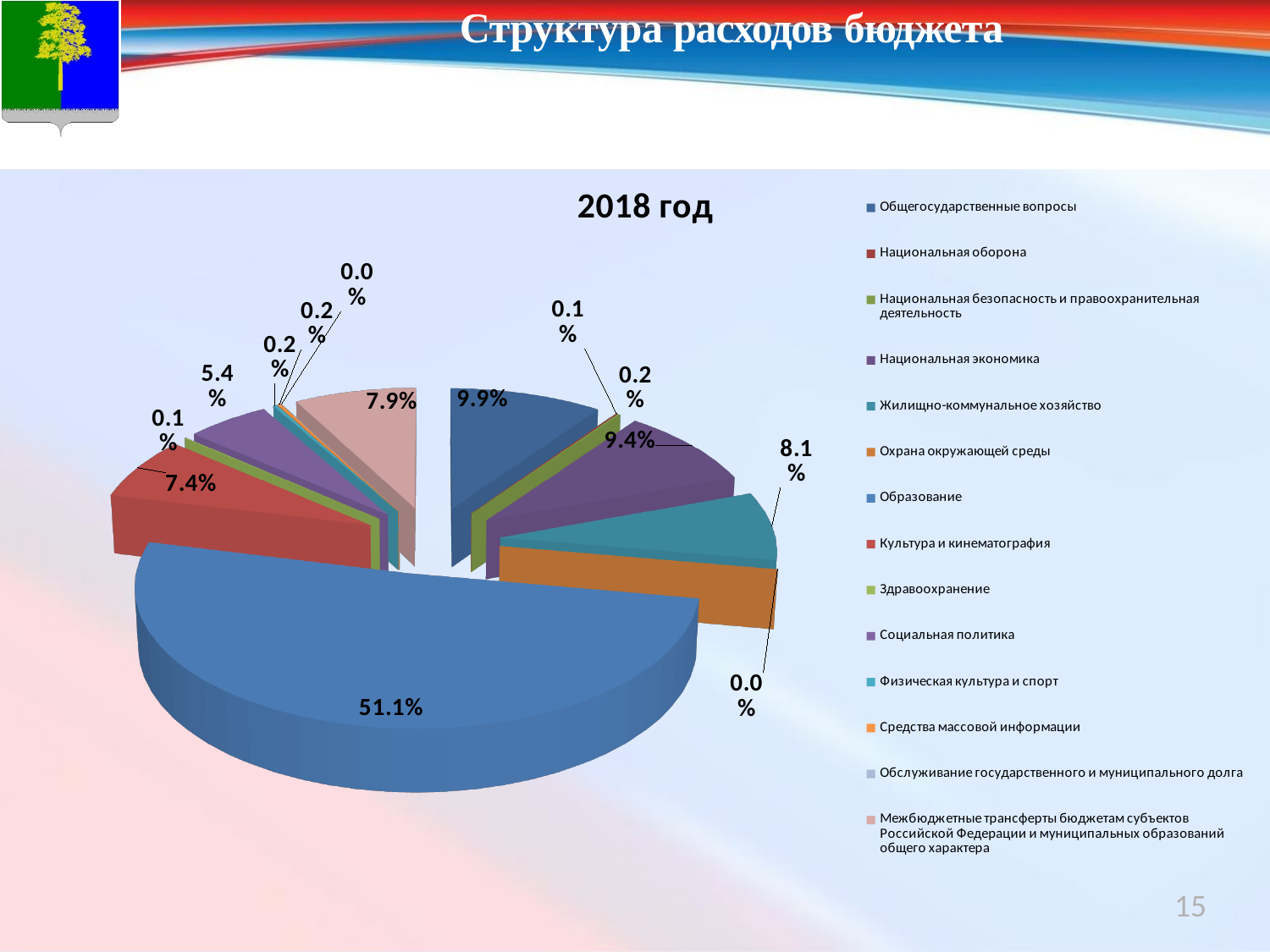
How many categories does the legend of the pie chart list? 14 Which is larger, the share for Общегосударственные вопросы or the share for Жилищно-коммунальное хозяйство? Общегосударственные вопросы What is the difference in percentage points between the share for Образование and the share for Общегосударственные вопросы? 41.2 What share of the pie does Образование have? 51.1% What is the value shown for Культура и кинематография? 7.4% What is the title of the pie chart? 2018 год Which category has the largest share of the pie? Образование What kind of chart is shown on the slide? pie chart What is the value shown for Общегосударственные вопросы? 9.9% What is the value shown for Национальная экономика? 9.4% What is the value shown for Жилищно-коммунальное хозяйство? 8.1% What is the value shown for Социальная политика? 5.4%